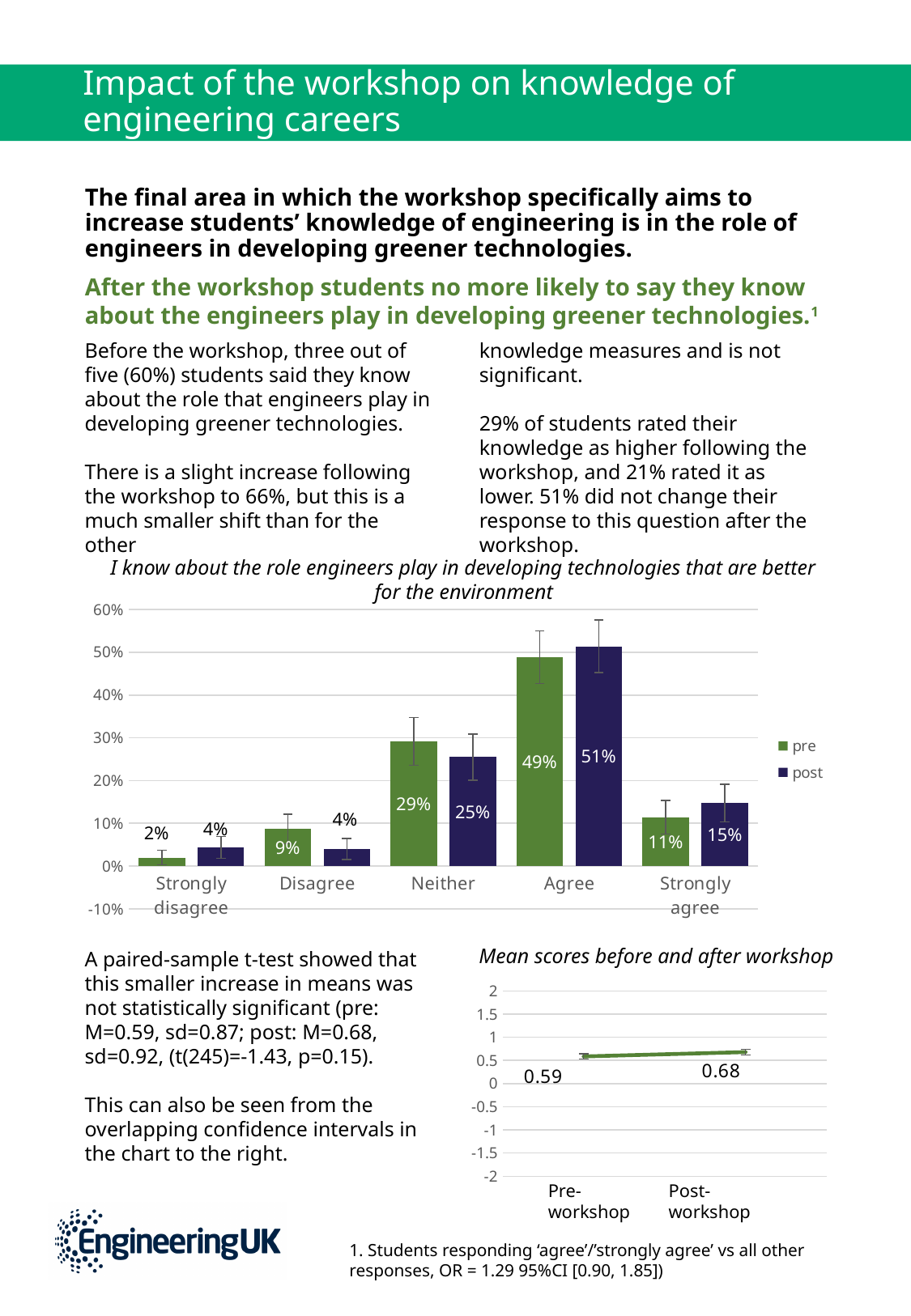
In the bar chart titled "I know about the role engineers play in developing technologies that are better for the environment", which category has the highest post value? Agree In the bar chart titled "I know about the role engineers play in developing technologies that are better for the environment", what is the post value for Neither? 25% In the bar chart titled "I know about the role engineers play in developing technologies that are better for the environment", what is the post value for Strongly agree? 15% In the chart titled "Mean scores before and after workshop", what is the value for Post-workshop? 0.68 In the bar chart titled "I know about the role engineers play in developing technologies that are better for the environment", is the pre value for Neither larger or smaller than the post value for Neither? larger In the bar chart titled "I know about the role engineers play in developing technologies that are better for the environment", which category has the lowest pre value? Strongly disagree In the bar chart titled "I know about the role engineers play in developing technologies that are better for the environment", how many series does the legend list? 2 In the bar chart titled "I know about the role engineers play in developing technologies that are better for the environment", what is the difference between the pre and post values for Disagree? 5% In the chart titled "Mean scores before and after workshop", does the value rise or fall from Pre-workshop to Post-workshop? rise In the bar chart titled "I know about the role engineers play in developing technologies that are better for the environment", what is the pre value for Agree? 49% In the bar chart titled "I know about the role engineers play in developing technologies that are better for the environment", how many response categories are shown on the x axis? 5 What kind of chart is the chart titled "Mean scores before and after workshop"? line chart